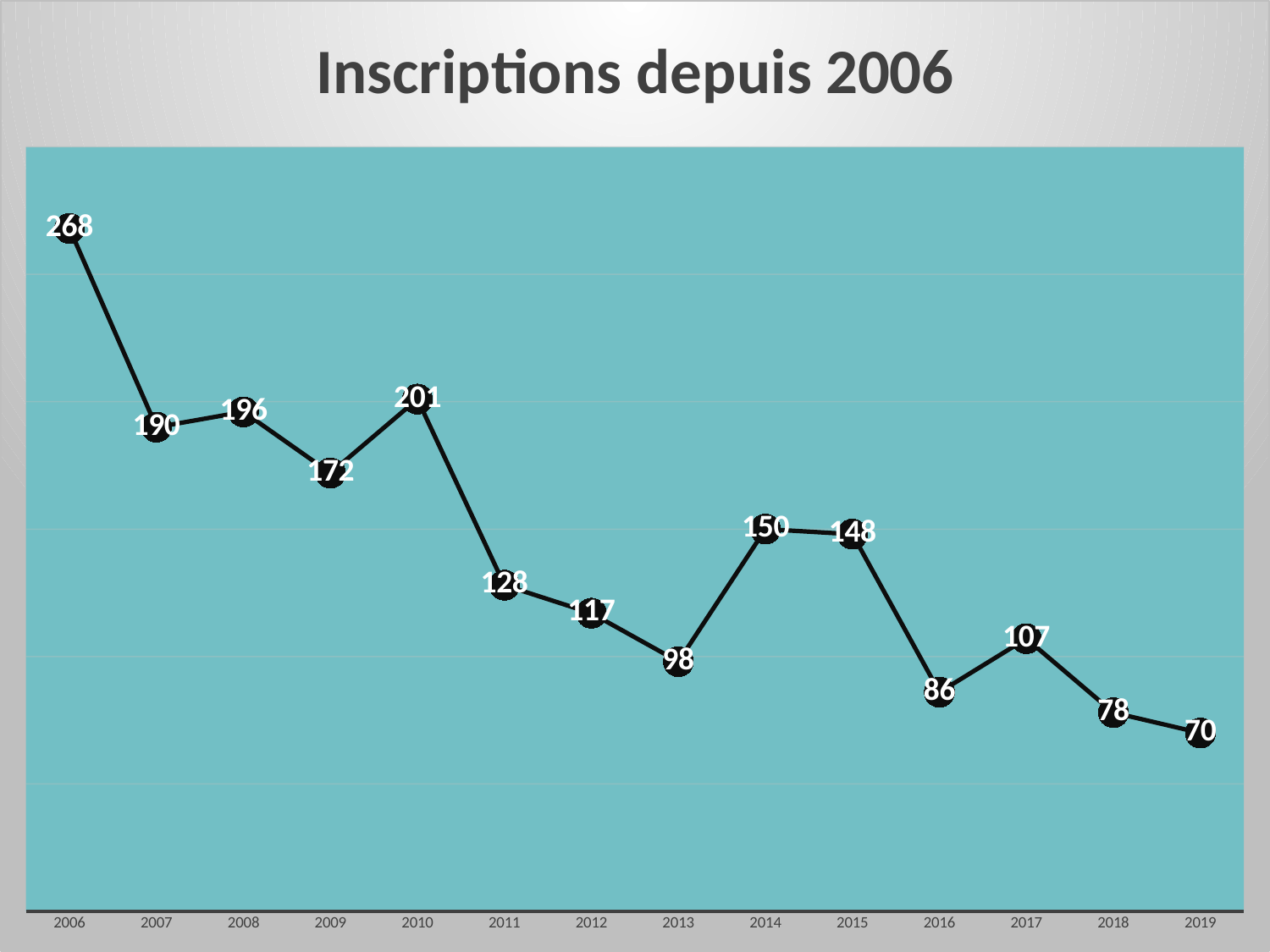
What is the value for 2014? 150 Which is larger, the value for 2009 or the value for 2010? 2010 What is the value for 2006? 268 What kind of chart is this? line chart Which year has the lowest value? 2019 How many years are plotted on the chart? 14 Which is larger, the value for 2016 or the value for 2017? 2017 What is the difference between the values for 2010 and 2011? 73 Which year has the highest value? 2006 Do the values generally rise or fall from 2006 to 2019? fall What is the value for 2019? 70 What is the difference between the values for 2006 and 2007? 78